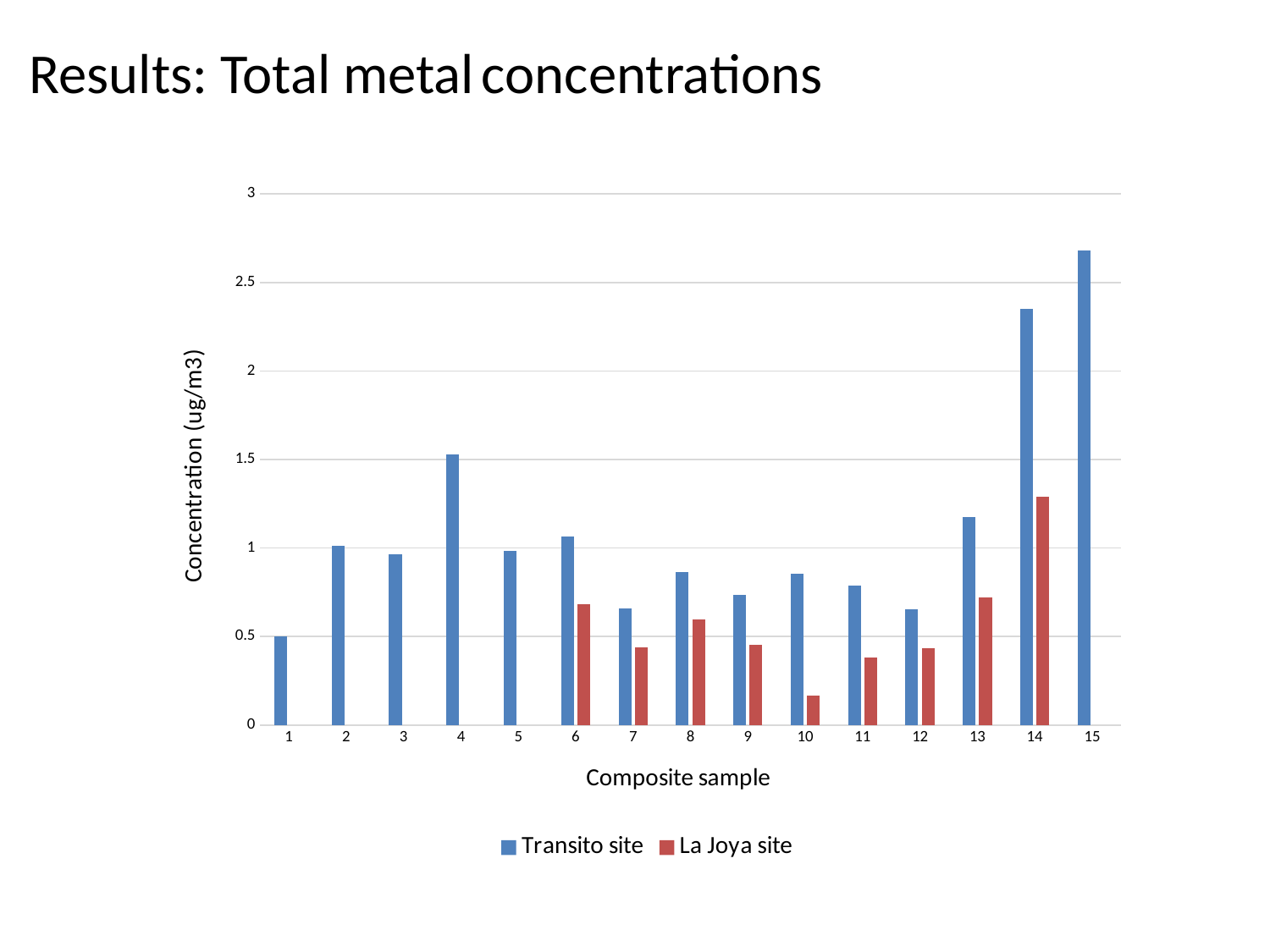
For composite sample 14, which site has the larger concentration, Transito site or La Joya site? Transito site Which composite sample has the lowest La Joya site concentration? 10 How many composite samples are shown on the x axis? 15 What kind of chart is shown on the slide? Bar chart Is the La Joya site value for composite sample 10 greater or less than 0.5? less Which composite sample has the highest La Joya site concentration? 14 How many series does the legend list? 2 What is the label of the y axis? Concentration (ug/m3) Is the Transito site value for composite sample 15 greater or less than 2.5? greater Which composite sample has the highest Transito site concentration? 15 Which is larger, the Transito site value for composite sample 4 or for composite sample 13? Composite sample 4 Which composite sample has the lowest Transito site concentration? 1